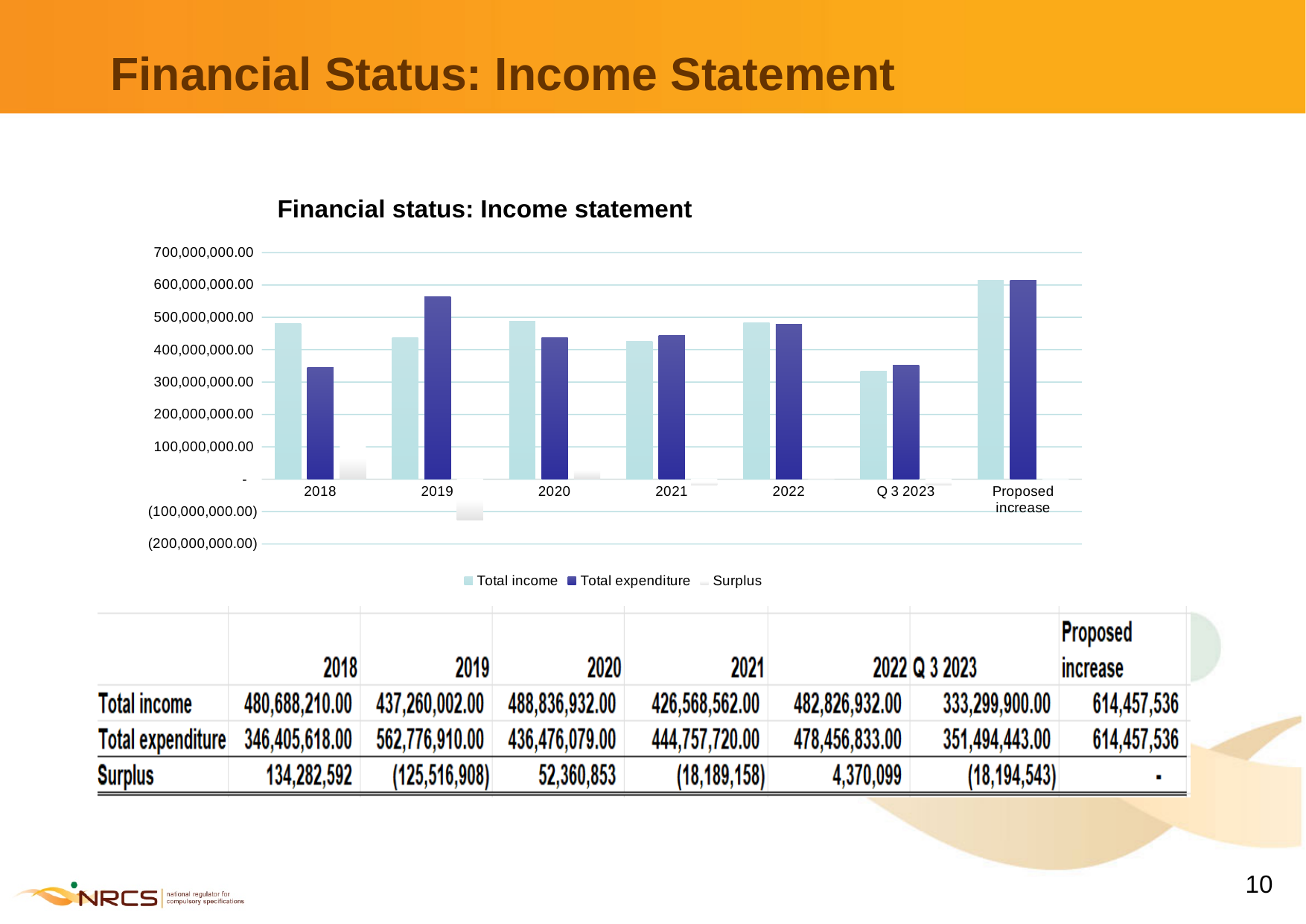
Does Total expenditure rise or fall from 2018 to 2019? Rise What is the Total income value for 2018? 480,688,210.00 How many categories are shown along the x axis of the chart? 7 Which category has the highest Total income? Proposed increase What kind of chart is shown on the slide? Bar chart What is the Surplus value for 2022? 4,370,099 What is the difference between Total income and Total expenditure in 2018? 134,282,592 What are the three series named in the chart legend? Total income, Total expenditure, Surplus How many series does the legend of the chart list? 3 Which category has the lowest Total income? Q 3 2023 In 2019, which is larger: Total income or Total expenditure? Total expenditure Is the Total expenditure value for 2018 greater or less than 400,000,000.00? less